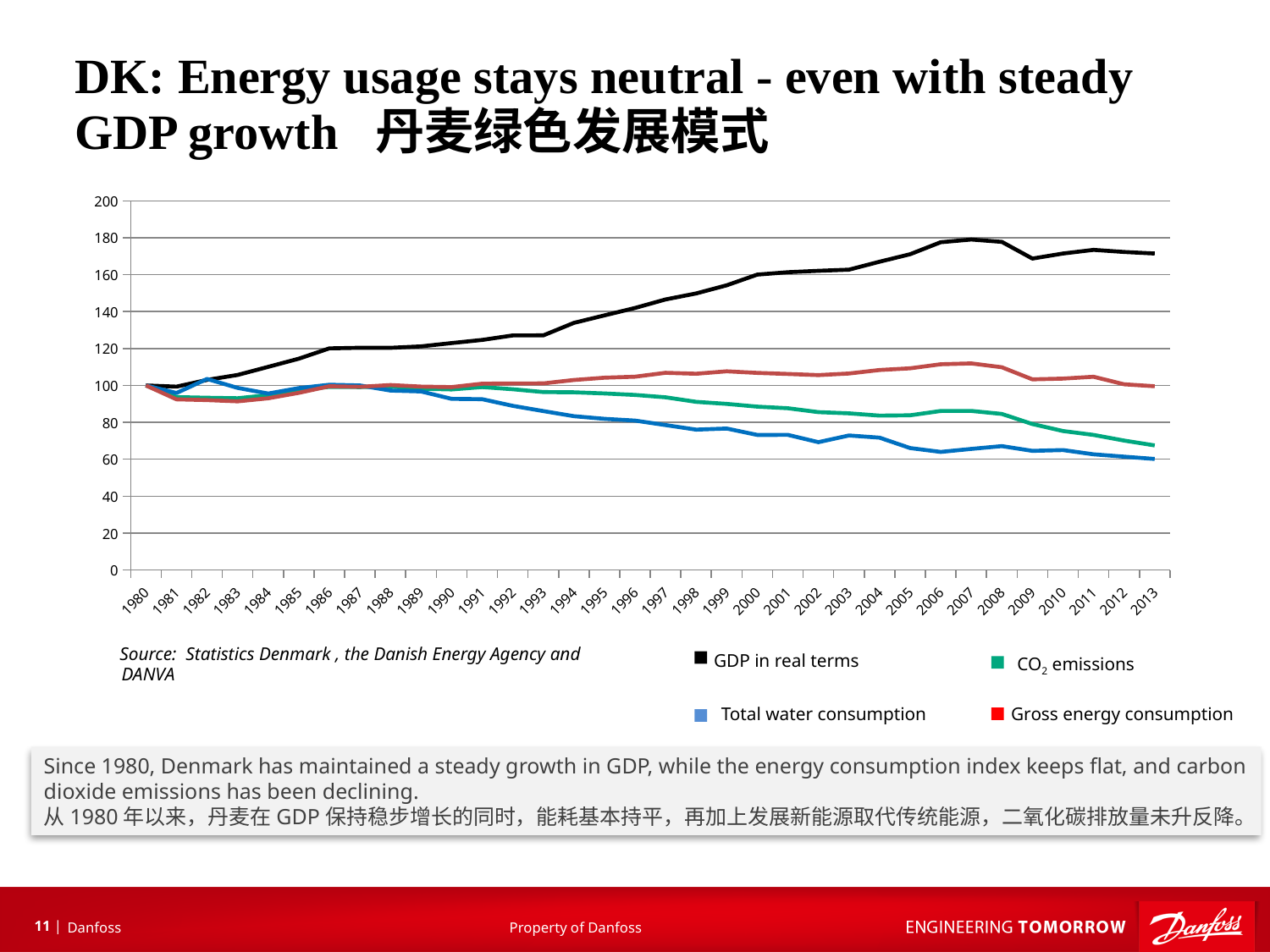
What colour is the GDP in real terms line in the chart? Black Does the CO2 emissions line rise or fall from 1980 to 2013? Falls How many years are shown along the x axis of the chart? 34 Which series has the highest value in 2013? GDP in real terms Is the value for GDP in real terms in 2013 greater or less than 160? greater How many series does the chart's legend list? 4 Is the value for Total water consumption in 2013 greater or less than 80? less Does the GDP in real terms line rise or fall from 1980 to 2013? Rises In 2013, which is larger: CO2 emissions or Gross energy consumption? Gross energy consumption What kind of chart is shown on the slide? Line chart Which series has the lowest value in 2013? Total water consumption Is the value for CO2 emissions in 2013 greater or less than 80? less